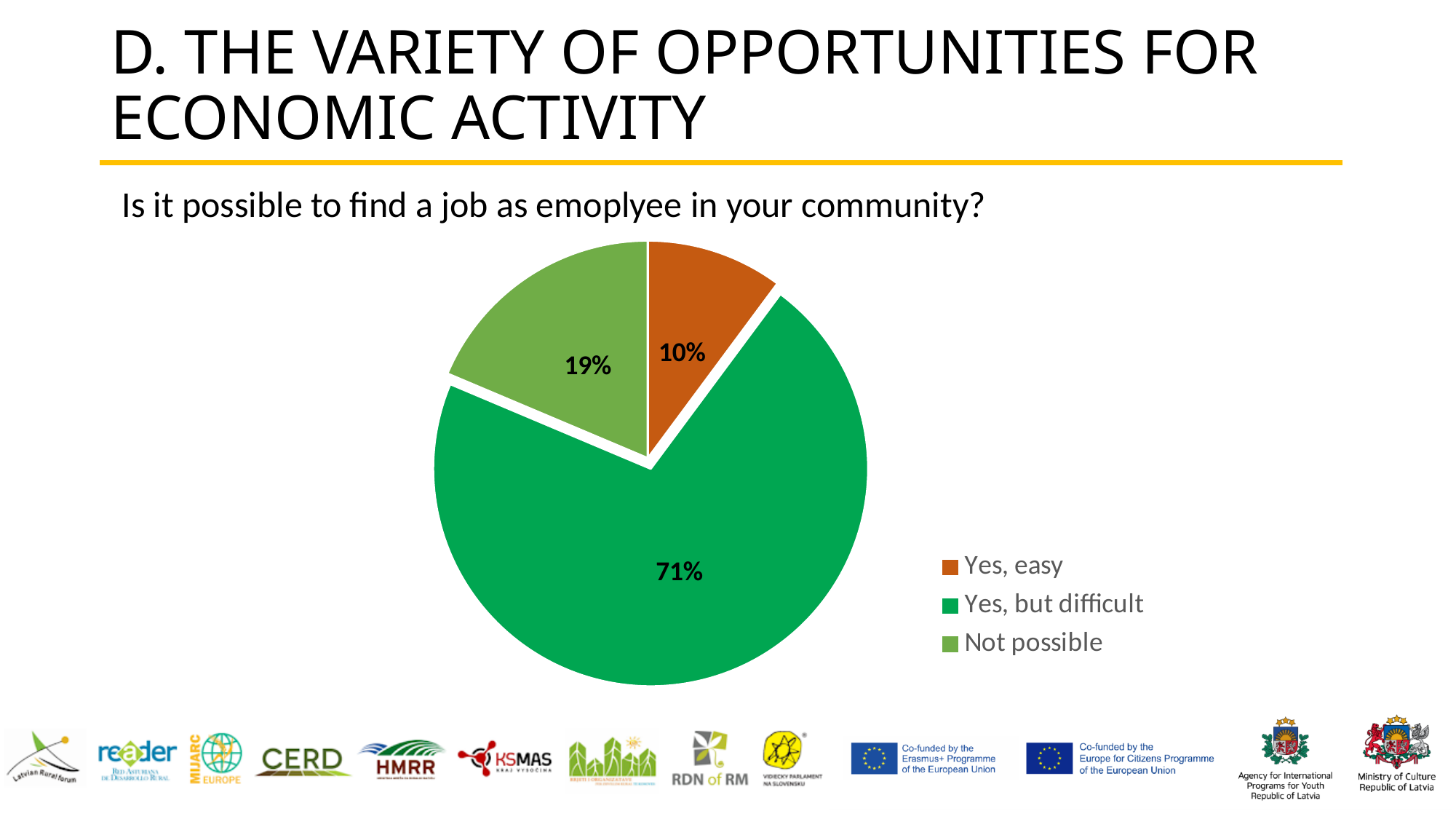
How many entries does the legend list? 3 Which response has the smallest share of the pie? Yes, easy How many slices does the pie chart have? 3 What colour is the "Yes, easy" slice? Orange-brown Which is larger: the share for "Not possible" or the share for "Yes, easy"? Not possible What is the difference in percentage points between "Not possible" and "Yes, easy"? 9 What kind of chart is shown on the slide? Pie chart Which response has the largest share of the pie? Yes, but difficult What share of respondents answered "Yes, but difficult"? 71% What is the difference in percentage points between "Yes, but difficult" and "Not possible"? 52 What share of respondents answered "Not possible"? 19% What share of respondents answered "Yes, easy"? 10%